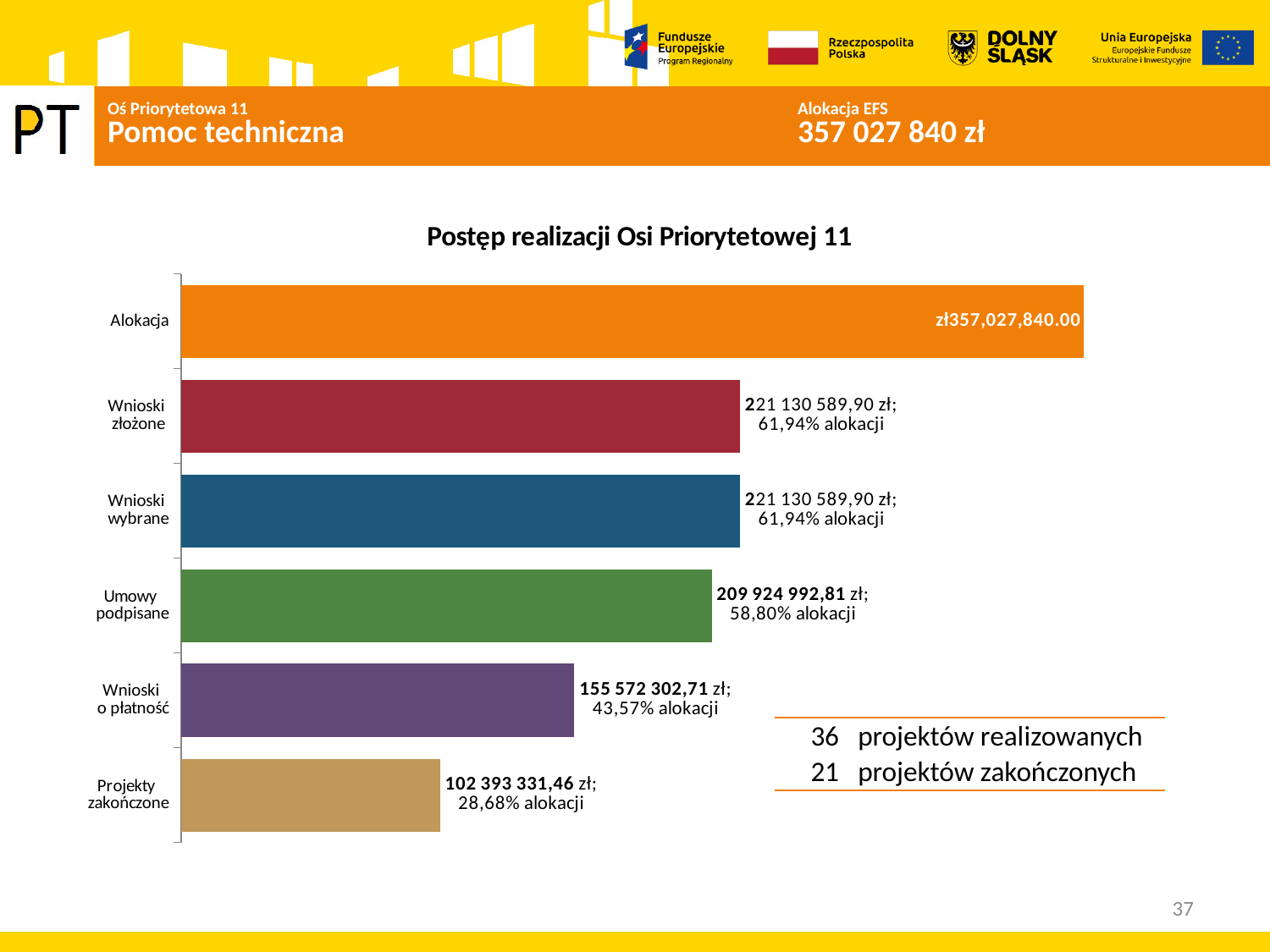
By how many percentage points does the share for Wnioski złożone exceed the share for Umowy podpisane? 3,14 Which category has the lowest value in the chart? Projekty zakończone What amount is shown for Projekty zakończone? 102 393 331,46 zł What type of chart is shown on the slide? Bar chart Which is larger, Umowy podpisane or Wnioski o płatność? Umowy podpisane What is the title of the chart? Postęp realizacji Osi Priorytetowej 11 How many categories are shown in the chart? 6 What percentage of the allocation do Wnioski o płatność represent? 43,57% alokacji What is the difference between Umowy podpisane and Wnioski o płatność? 54 352 690,10 zł Which category has the highest value in the chart? Alokacja What amount is shown for Umowy podpisane? 209 924 992,81 zł What value is shown for Alokacja in the chart? zł357,027,840.00